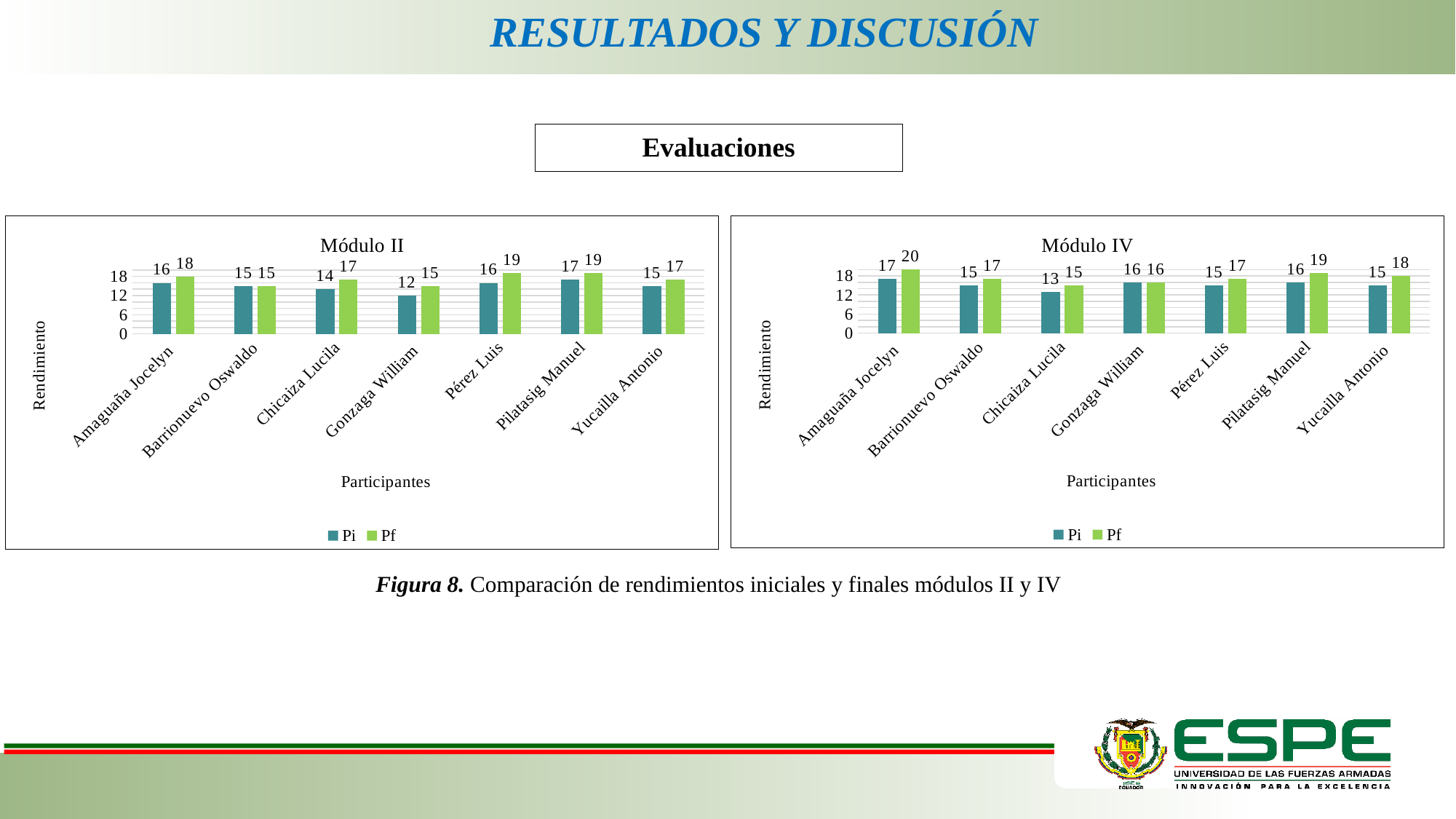
In the Módulo II chart, which is larger for Chicaiza Lucila, Pi or Pf? Pf In the Módulo II chart, what is the Pi value for Gonzaga William? 12 What type of chart is the Módulo IV chart? Bar chart In the Módulo IV chart, which participant has the lowest Pi value? Chicaiza Lucila In the Módulo IV chart, what is the difference between the Pf and Pi values for Pilatasig Manuel? 3 In the Módulo II chart, which participant has the lowest Pi value? Gonzaga William How many participants are shown in the Módulo IV chart? 7 How many series does the legend of the Módulo II chart list? 2 In the Módulo II chart, what is the Pf value for Pérez Luis? 19 In the Módulo IV chart, what is the Pi value for Chicaiza Lucila? 13 In the Módulo IV chart, what is the Pf value for Amaguaña Jocelyn? 20 In the Módulo II chart, which participant has the highest Pi value? Pilatasig Manuel